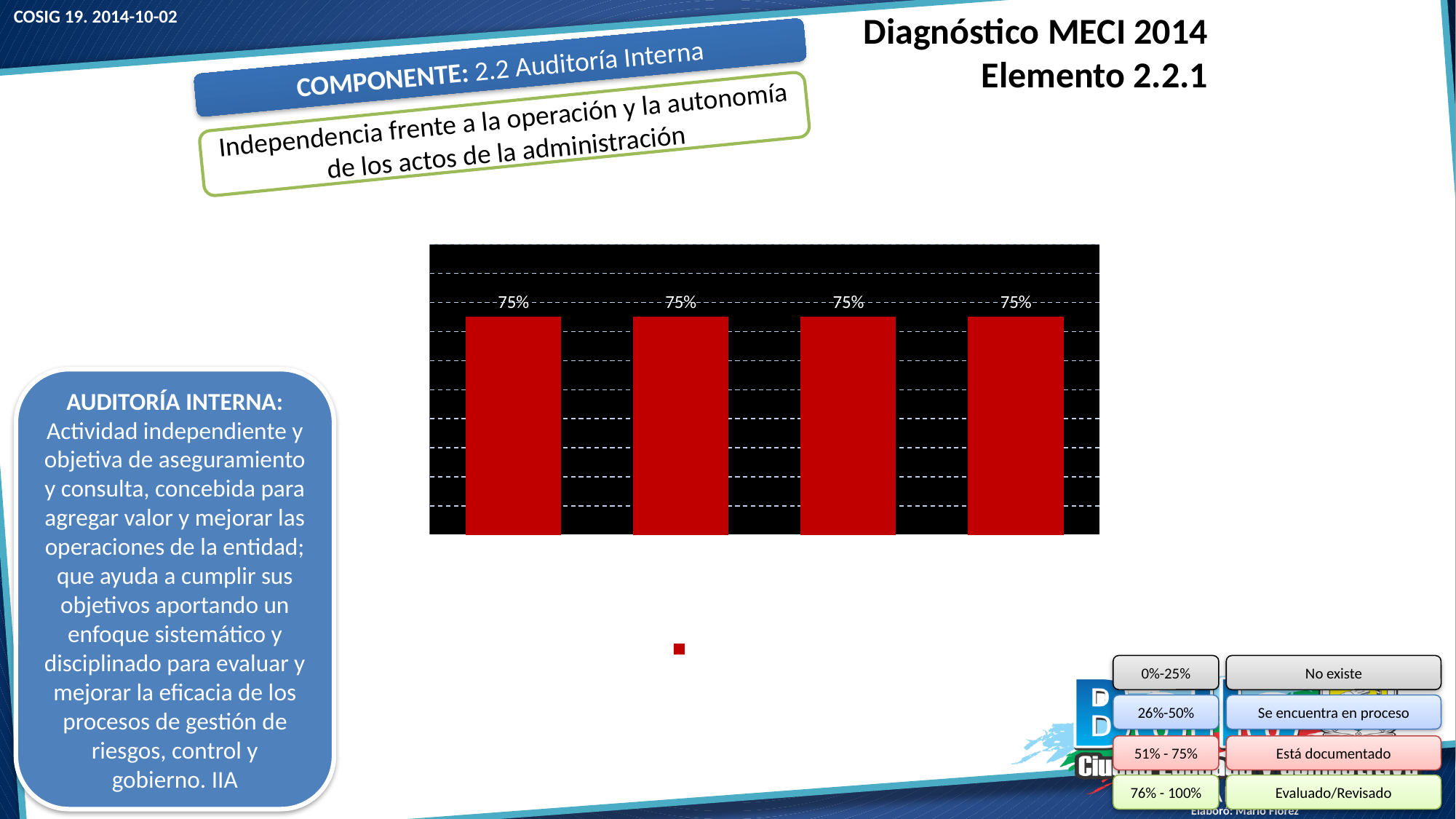
Do the bar values rise, fall, or stay the same from left to right across the chart? stay the same What value is printed above the rightmost bar in the chart? 75% What colour is the plot area background of the chart? black What value is printed above the third bar from the left? 75% Is the value of the leftmost bar larger, smaller, or equal to the value of the rightmost bar? equal What kind of chart is shown on the slide? bar chart How many bars does the chart show? 4 What value is printed above the second bar from the left? 75% How many series does the chart's legend show? 1 What colour are the bars in the chart? red What value is printed above the leftmost bar in the chart? 75% What is the difference between the value of the first bar and the value of the last bar? 0%